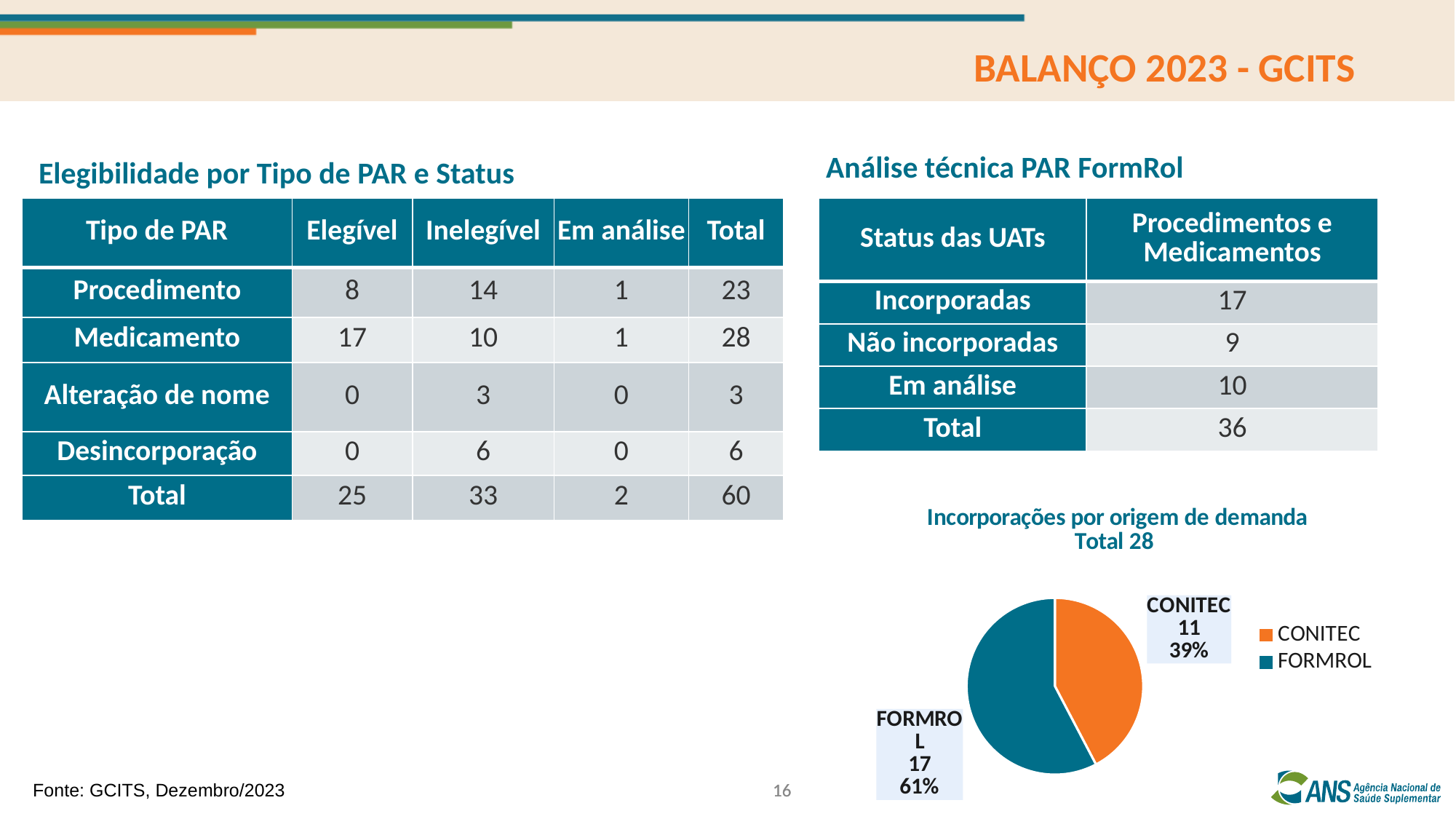
What is the difference between the FORMROL and CONITEC values in the pie chart? 6 How many entries does the pie chart's legend list? 2 What share of the pie does FORMROL represent? 61% Which colour represents CONITEC in the pie chart? orange What kind of chart is shown on the slide? pie chart What is the title of the pie chart? Incorporações por origem de demanda Total 28 Which slice of the pie chart is the largest? FORMROL Which slice of the pie chart is the smallest? CONITEC What is the value for FORMROL in the pie chart? 17 What share of the pie does CONITEC represent? 39% How many slices does the pie chart have? 2 What is the value for CONITEC in the pie chart? 11